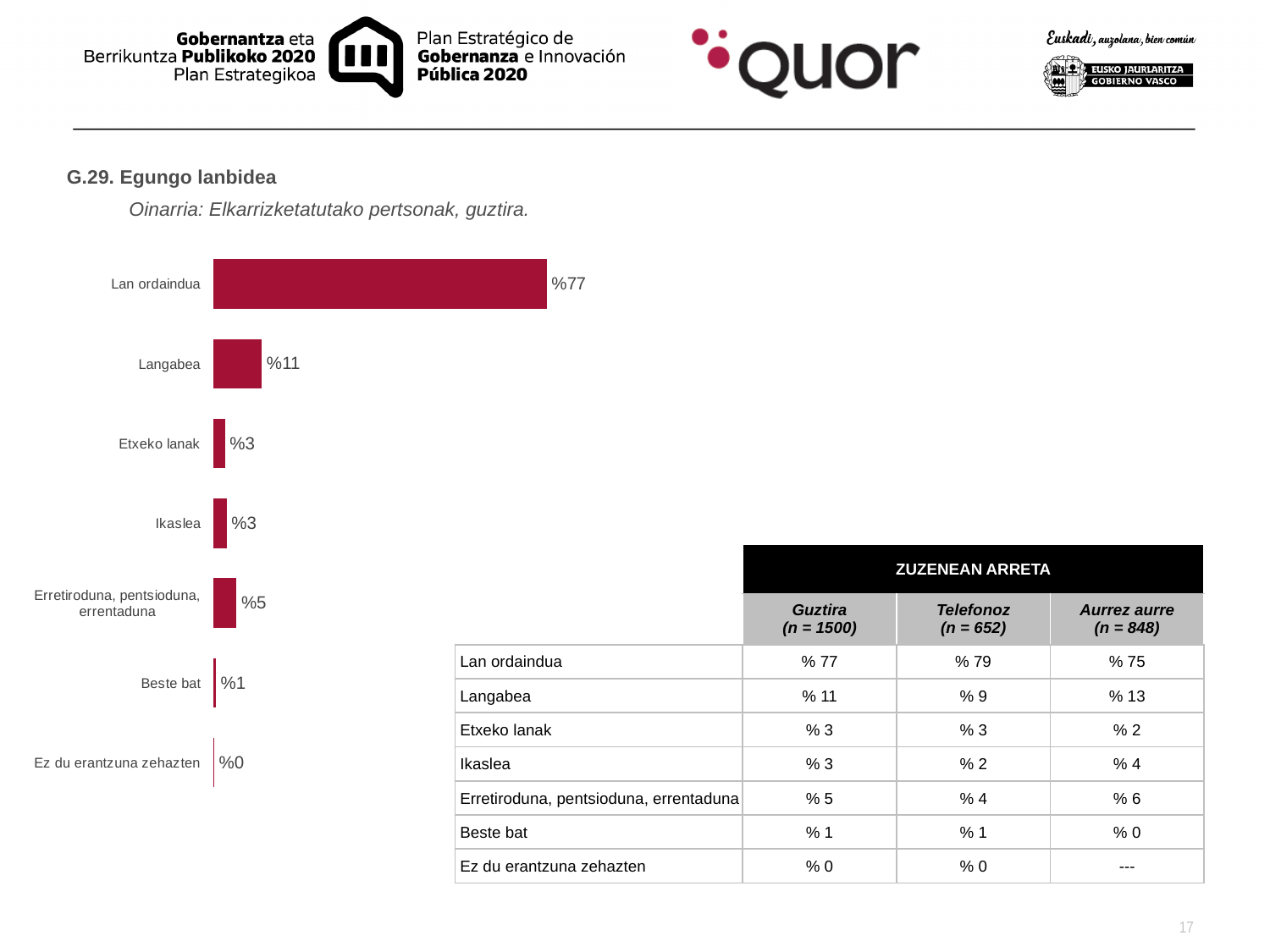
What is the difference between the values for Lan ordaindua and Langabea in the bar chart? %66 Which category has the highest value in the bar chart? Lan ordaindua What is the value for Beste bat in the bar chart? %1 What is the value for Erretiroduna, pentsioduna, errentaduna in the bar chart? %5 Which category has the lowest value in the bar chart? Ez du erantzuna zehazten What is the title of the chart on the slide? G.29. Egungo lanbidea What is the value for Lan ordaindua in the bar chart? %77 What kind of chart is shown on the slide? Bar chart What is the value for Langabea in the bar chart? %11 What is the value for Ez du erantzuna zehazten in the bar chart? %0 Which is larger in the bar chart, the value for Langabea or the value for Erretiroduna, pentsioduna, errentaduna? Langabea How many categories are shown in the bar chart? 7